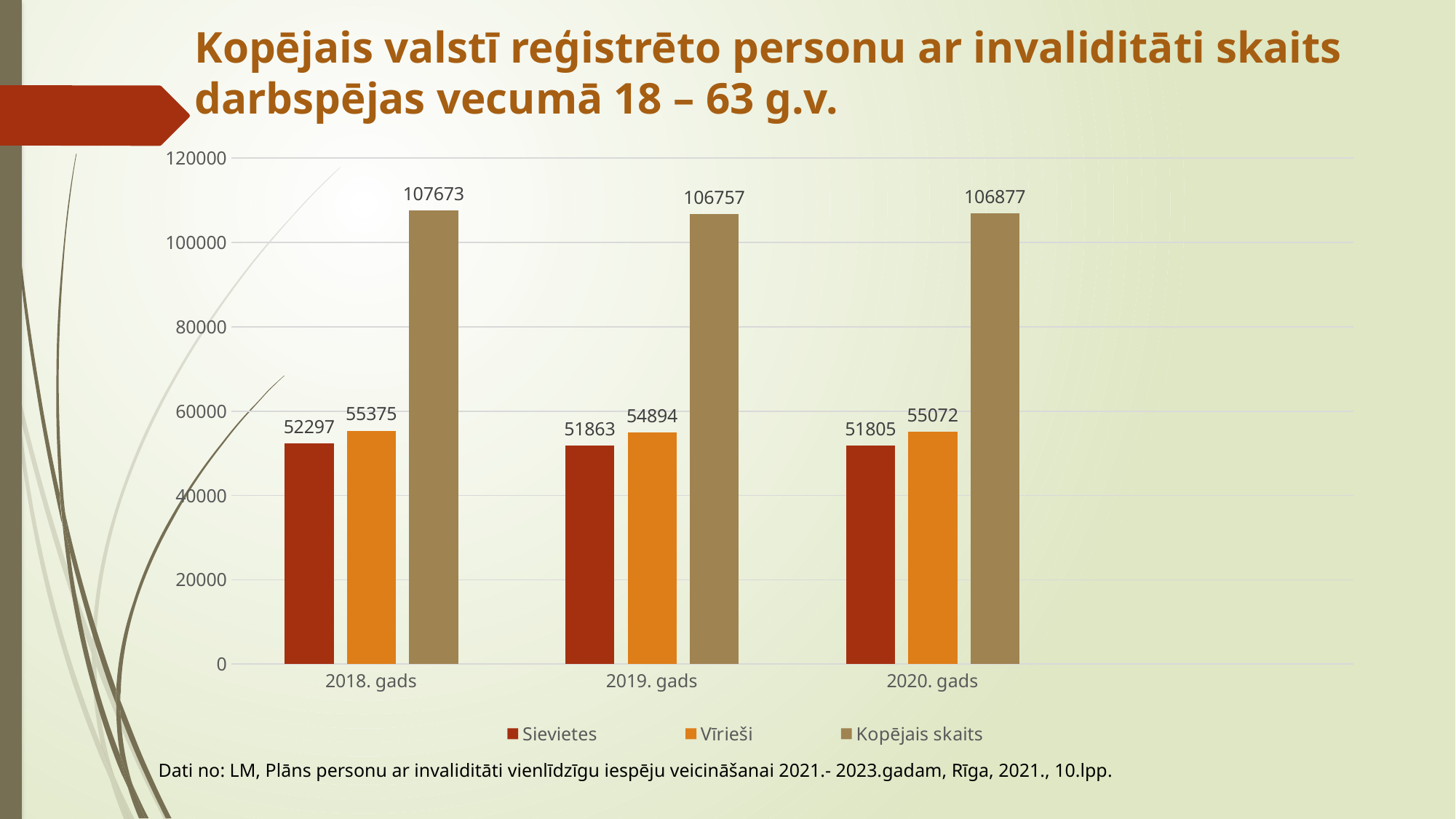
What is the difference between the Vīrieši and Sievietes values in 2020. gads? 3267 In which year is the Sievietes value lowest? 2020. gads Is the value for Kopējais skaits in 2019. gads greater or less than 100000? greater How many years are shown on the x axis? 3 What is the value for Kopējais skaits in 2020. gads? 106877 Which series is shown in orange in the legend? Vīrieši Which is larger in 2018. gads, the Sievietes value or the Vīrieši value? Vīrieši What kind of chart is shown on the slide? bar chart In which year is the Kopējais skaits value highest? 2018. gads How many series does the legend list? 3 What is the value for Vīrieši in 2019. gads? 54894 What is the value for Sievietes in 2018. gads? 52297